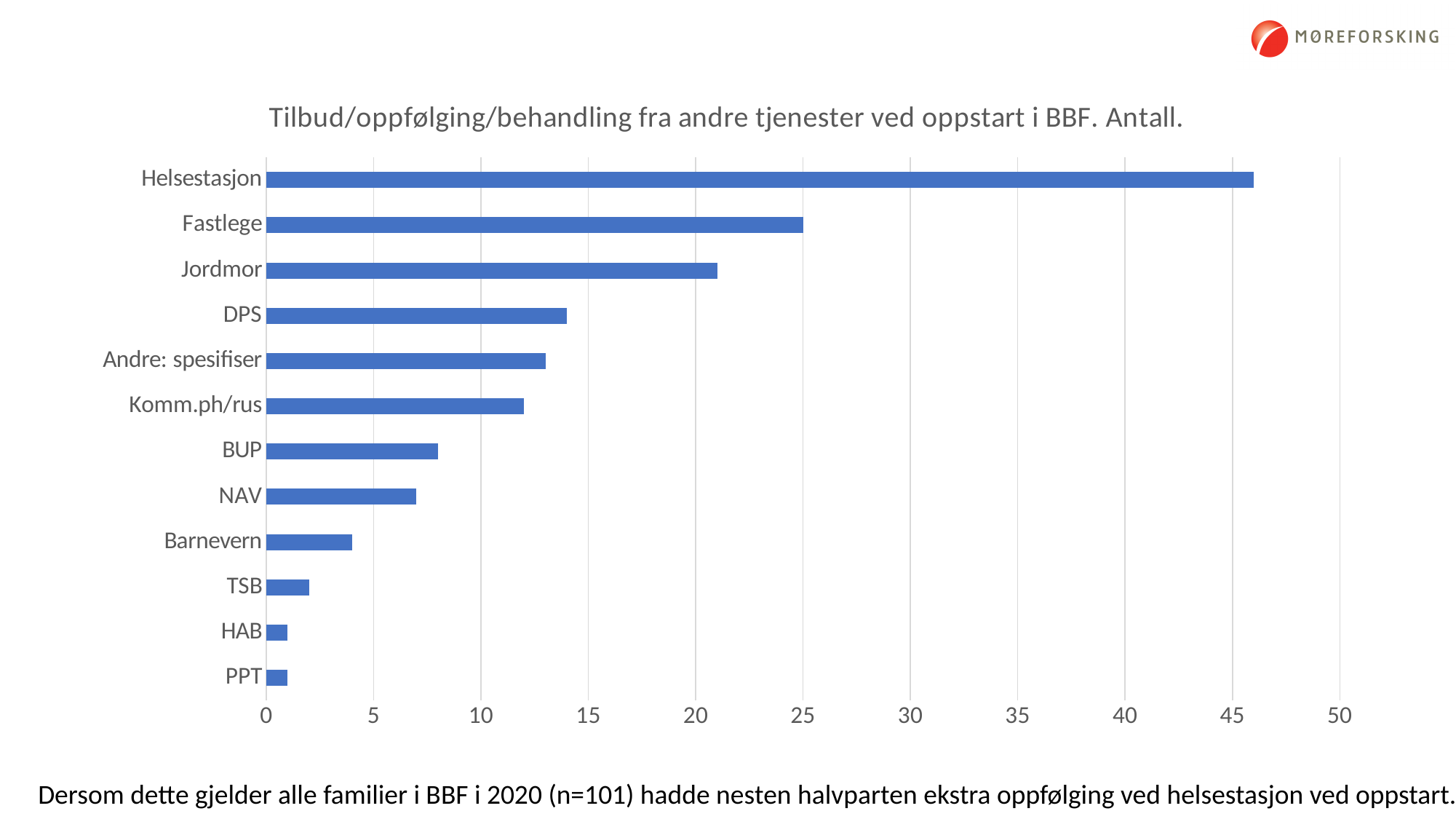
What kind of chart is shown on the slide? bar chart Is the value for DPS greater or less than 15? less Is the value for BUP greater or less than 10? less Which category has the highest value? Helsestasjon What is the title of the chart? Tilbud/oppfølging/behandling fra andre tjenester ved oppstart i BBF. Antall. Is the value for Barnevern greater or less than 5? less Which has a larger value, Komm.ph/rus or NAV? Komm.ph/rus How many categories are plotted in the chart? 12 What is the value for Fastlege? 25 Which has a larger value, Fastlege or Jordmor? Fastlege